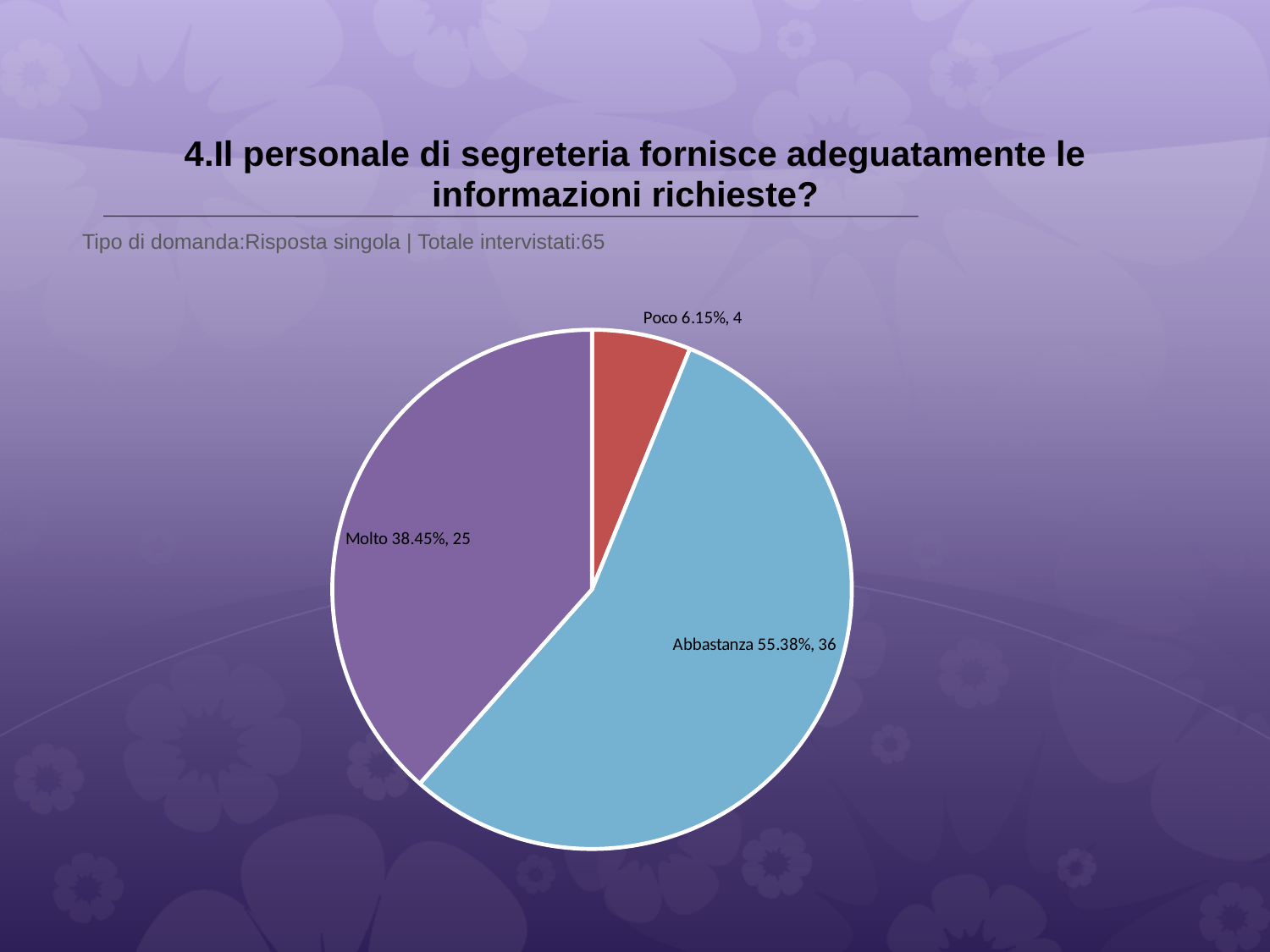
Which response has the largest slice of the pie? Abbastanza What percentage share does the Poco slice have? 6.15% What kind of chart is shown on the slide? pie chart How many more respondents answered Abbastanza than Molto? 11 Which slice is larger, Molto or Poco? Molto Which response has the smallest slice of the pie? Poco How many slices does the pie chart have? 3 How many respondents answered Molto? 25 What percentage share does the Abbastanza slice have? 55.38% What percentage share does the Molto slice have? 38.45% How many respondents answered Abbastanza? 36 How many respondents answered Poco? 4